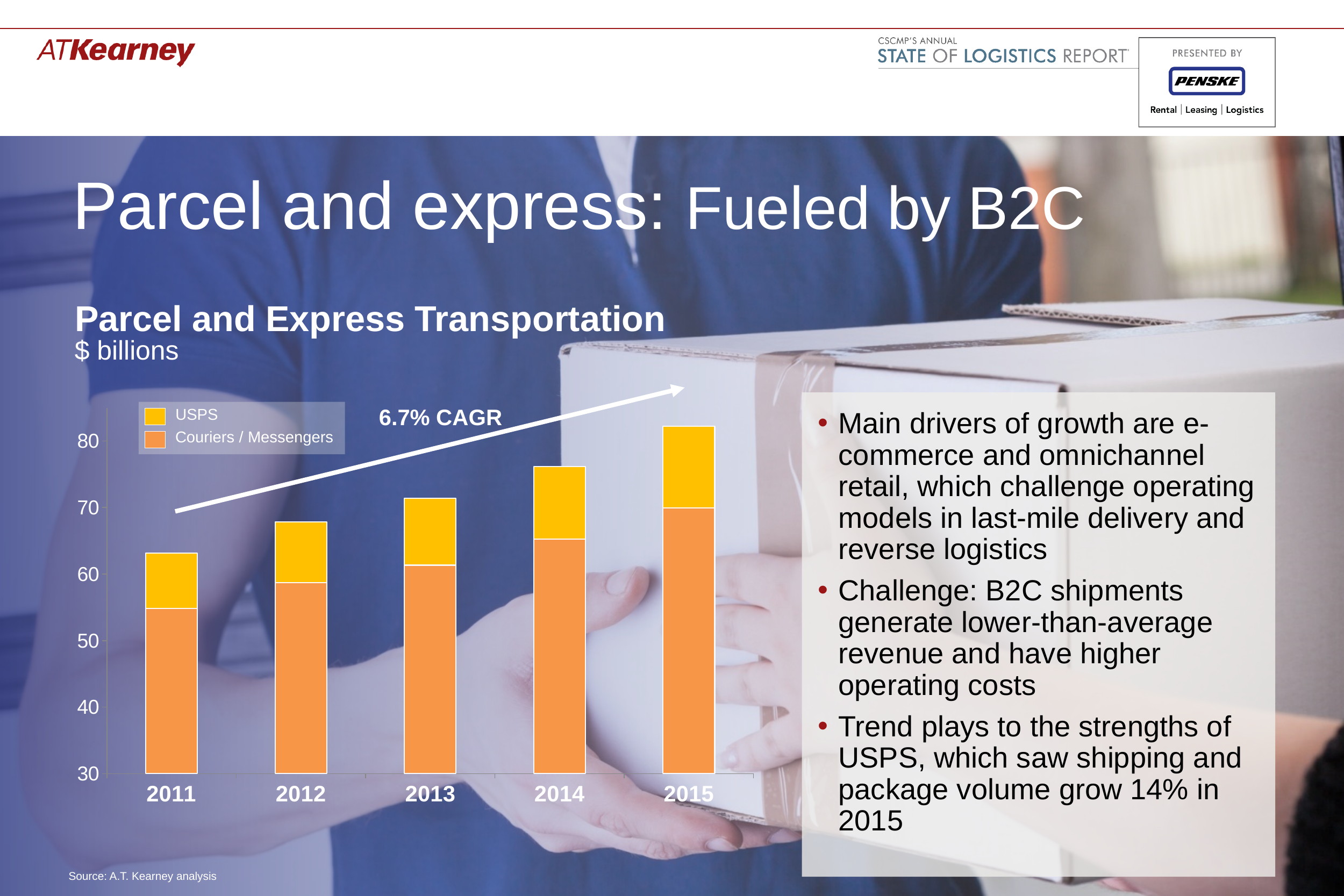
Is the total bar for 2012 greater or less than 70? less How many series does the legend of the chart list? 2 Is the Couriers / Messengers value for 2015 greater or less than 60? greater Is the total bar for 2011 greater or less than 60? greater What kind of chart is shown on the slide? Bar chart Which total bar is larger, 2014 or 2012? 2014 Which year has the highest total bar in the chart? 2015 Do the total bar values rise or fall from 2011 to 2015? Rise What CAGR is annotated on the chart? 6.7% CAGR Which year has the lowest total bar in the chart? 2011 How many years are shown on the x axis of the Parcel and Express Transportation chart? 5